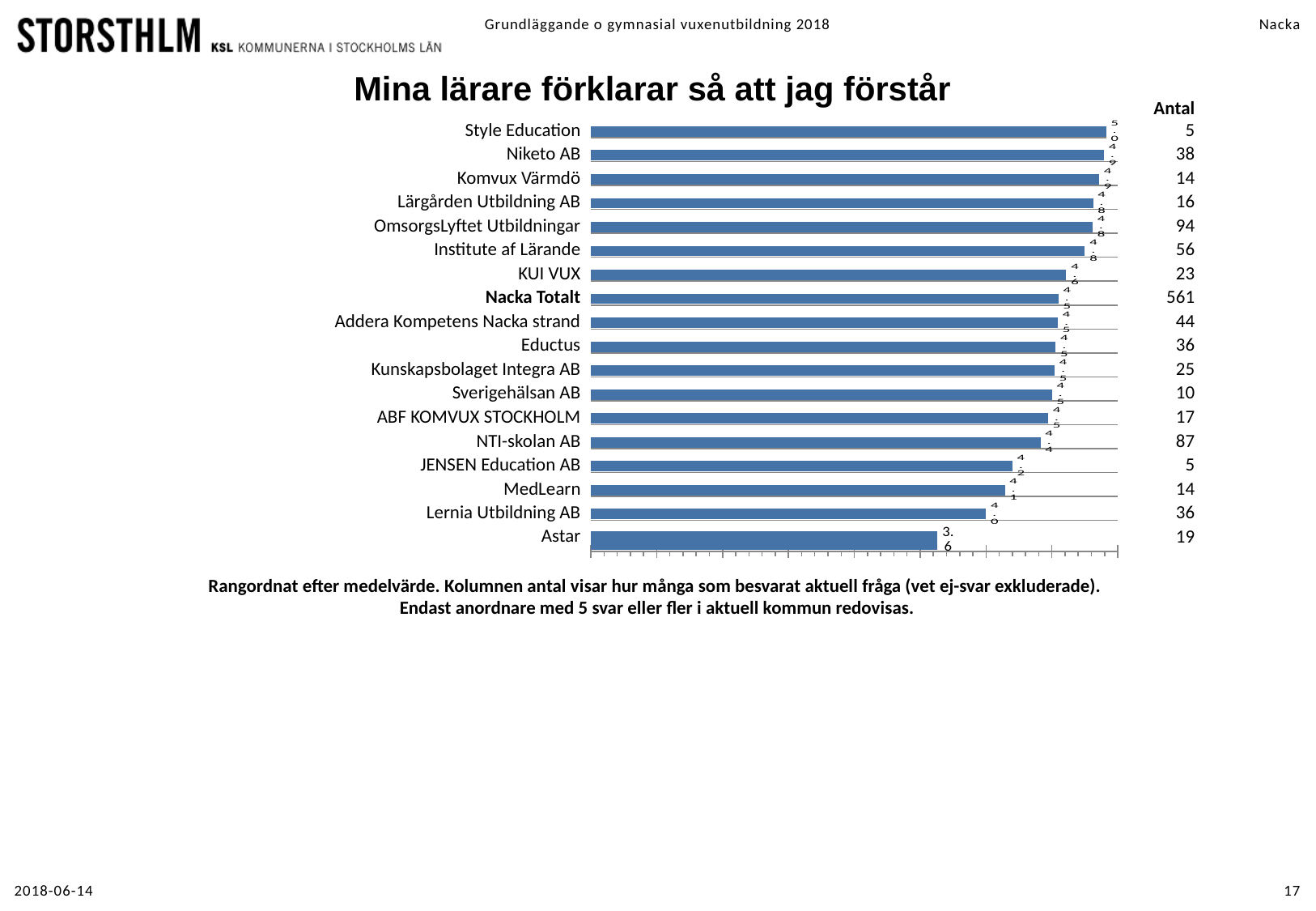
Which category has the shortest bar in the chart? Astar How many providers (categories) are plotted in the chart? 18 What is the value shown for Style Education? 5.0 What is the value shown for Astar? 3.6 Do the bar values increase or decrease going from the top of the chart to the bottom? decrease What is the title of the chart? Mina lärare förklarar så att jag förstår Which has a larger value, Niketo AB or MedLearn? Niketo AB Which category has the longest bar in the chart? Style Education What is the value shown for Lernia Utbildning AB? 4.0 What is the difference between the values for Lernia Utbildning AB and Astar? 0.4 Which has a larger value, Nacka Totalt or Astar? Nacka Totalt What kind of chart is shown on the slide? bar chart